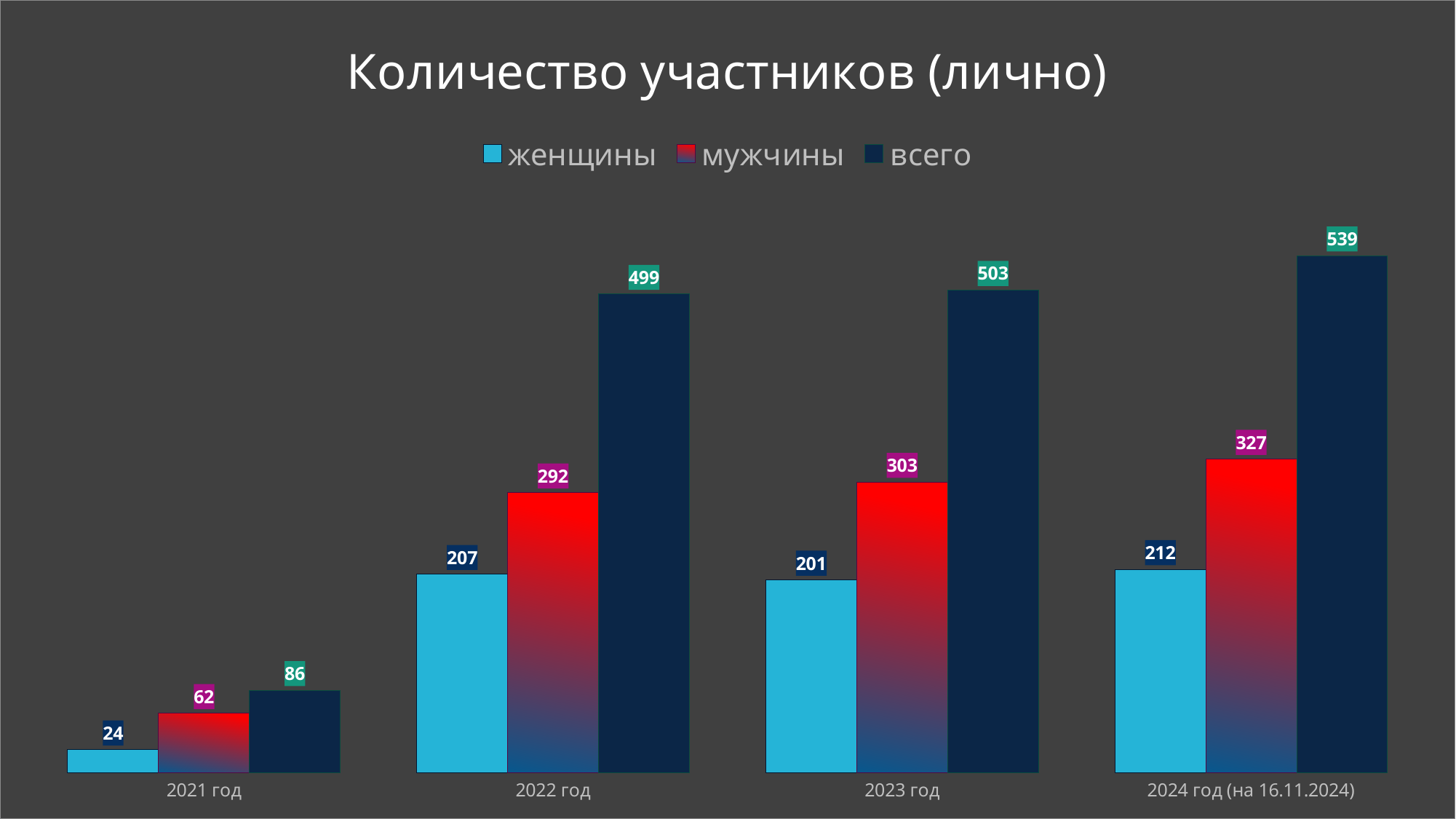
Does the value for всего rise or fall from 2021 год to 2024 год (на 16.11.2024)? rise Which year has the highest value for всего? 2024 год (на 16.11.2024) Which is larger: женщины in 2022 год or женщины in 2023 год? женщины in 2022 год What is the value for женщины in 2021 год? 24 What is the difference between мужчины and женщины in 2022 год? 85 How many series does the legend list? 3 What is the value for всего in 2024 год (на 16.11.2024)? 539 What is the title of the chart? Количество участников (лично) What is the value for мужчины in 2023 год? 303 Which year has the lowest value for мужчины? 2021 год What kind of chart is this? bar chart How many years are shown on the x axis? 4